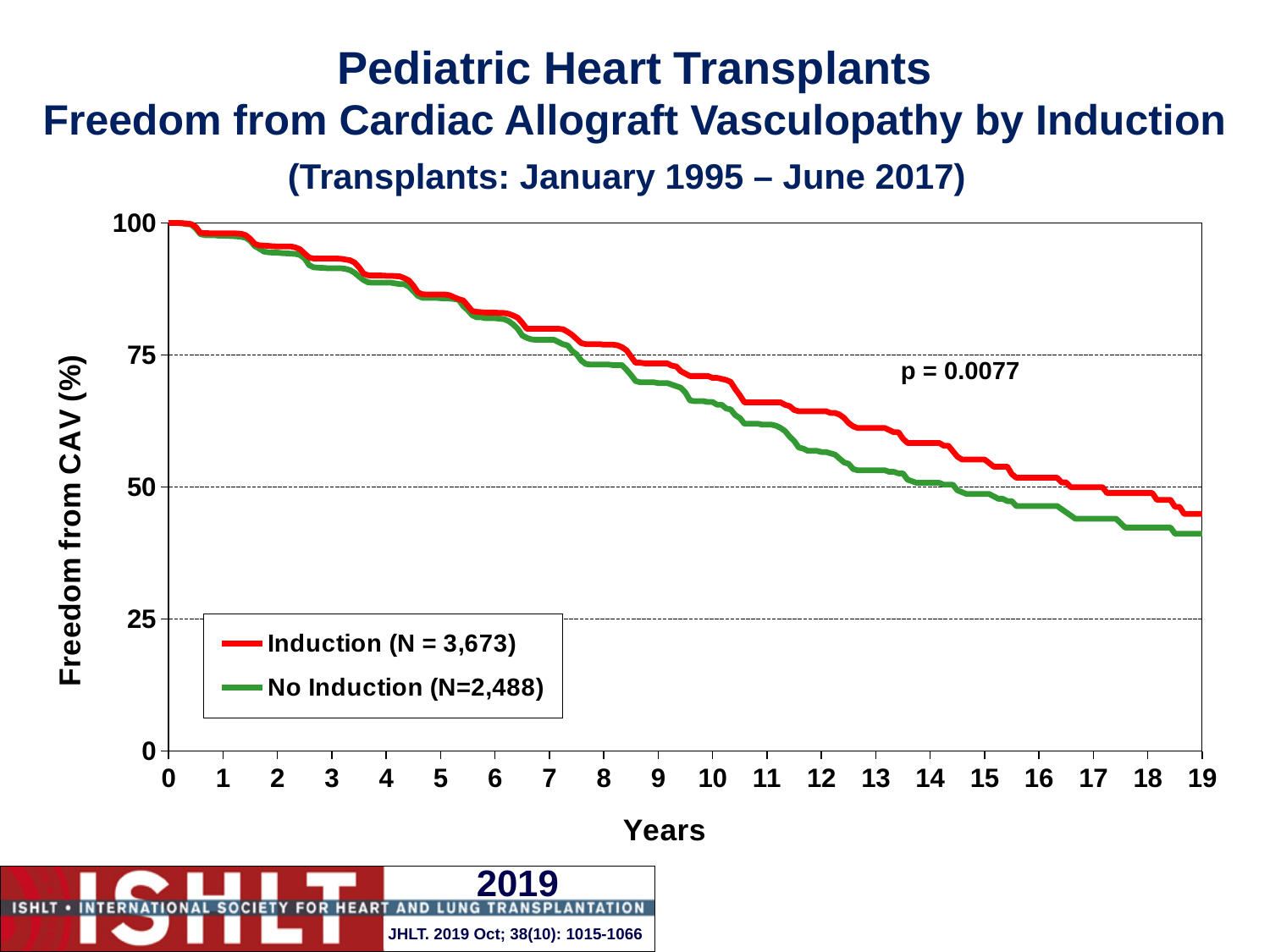
Is the freedom from CAV for the Induction group at year 10 greater or less than 75? less What is the N for the Induction group in the legend? 3,673 What kind of chart is shown on the slide? line chart Which series has the higher freedom from CAV at year 12, Induction or No Induction? Induction Is the freedom from CAV for the Induction group at year 19 greater or less than 50? less What p-value is shown on the chart? p = 0.0077 Is the freedom from CAV for the Induction group at year 13 greater or less than 50? greater How many series does the legend list? 2 Do the freedom from CAV values rise or fall as years increase? fall